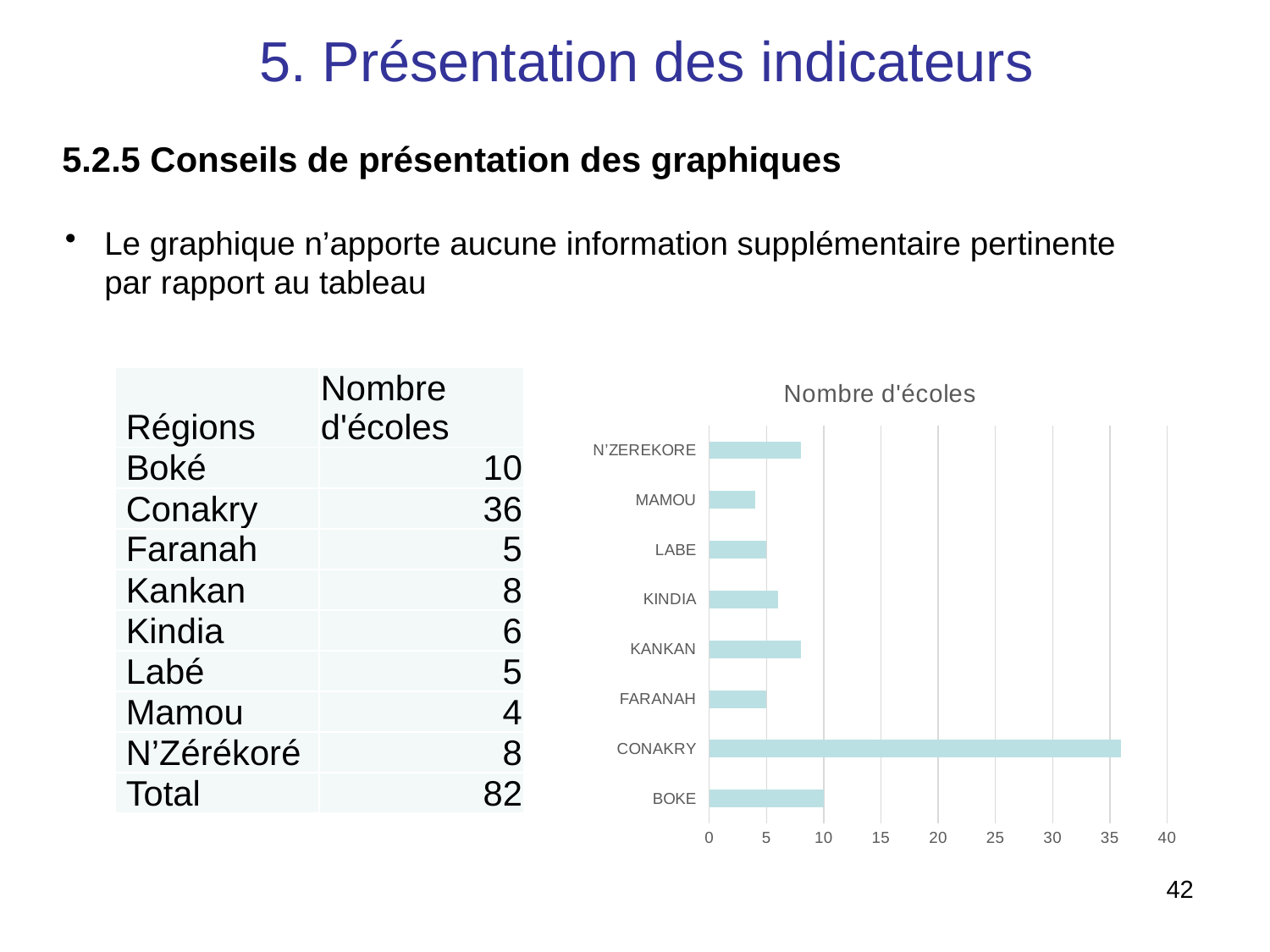
What is the difference in number of schools between Conakry and Boké? 26 Is the value for Conakry greater or less than 35? greater What is the number of schools for Conakry? 36 Which region has the lowest number of schools in the chart? Mamou What is the total number of schools across all regions shown? 82 Which region has the highest number of schools in the chart? Conakry What is the number of schools for Boké? 10 Is the value for Boké greater or less than 15? less Which has more schools, Kankan or Kindia? Kankan How many regions are plotted in the chart? 8 What is the title of the chart? Nombre d'écoles What kind of chart is shown on the slide? bar chart